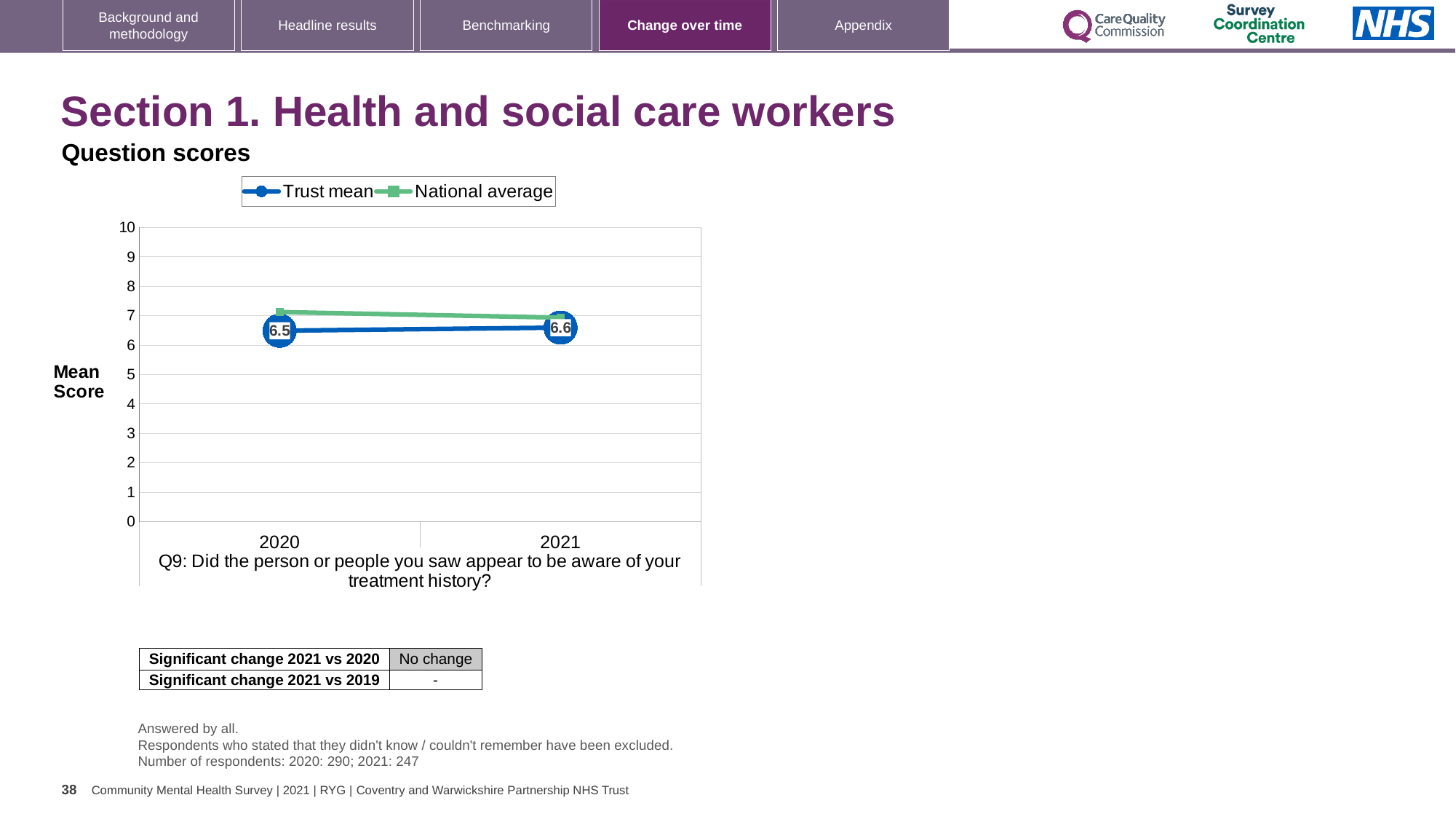
In 2020, which series is higher: Trust mean or National average? National average How many series does the chart legend list? 2 What kind of chart is shown on the slide? Line chart Does the Trust mean rise or fall from 2020 to 2021? Rise What is the Trust mean score for 2021? 6.6 What is the label on the y axis of the chart? Mean Score By how much did the Trust mean change from 2020 to 2021? 0.1 How many years are shown on the x axis of the chart? 2 Is the National average value for 2021 greater or less than 8? less What is the Trust mean score for 2020? 6.5 Is the National average value for 2020 greater or less than 6? greater Which year has the higher Trust mean, 2020 or 2021? 2021